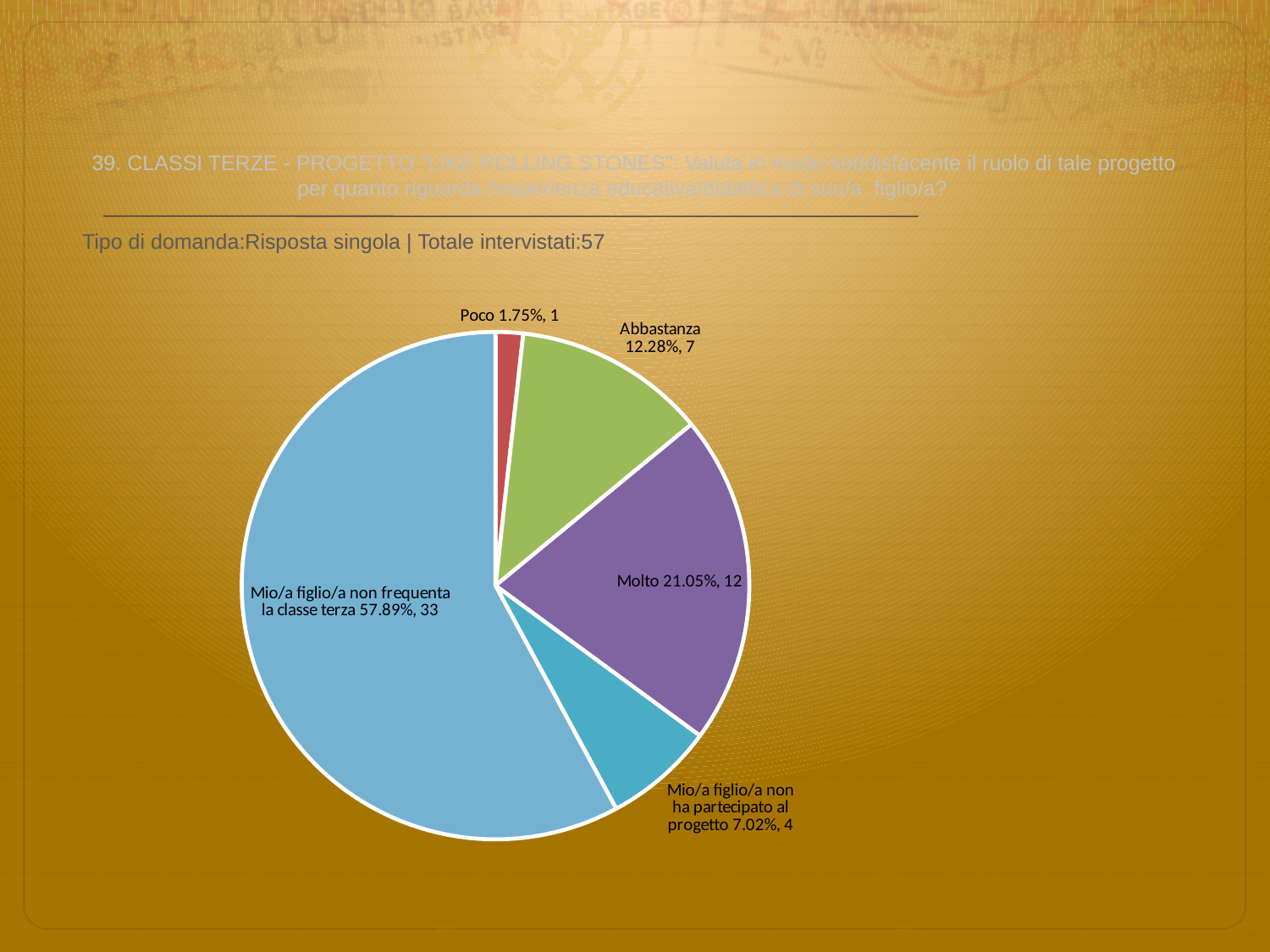
What is the difference in count between 'Molto' and 'Abbastanza'? 5 What kind of chart is shown on the slide? pie chart What percentage share does the 'Molto' slice have? 21.05% How many respondents answered 'Mio/a figlio/a non frequenta la classe terza'? 33 How many respondents answered 'Abbastanza'? 7 What percentage share does the 'Poco' slice have? 1.75% How many slices does the pie chart have? 5 Which is larger, the 'Abbastanza' slice or the 'Mio/a figlio/a non ha partecipato al progetto' slice? Abbastanza What is the total number of respondents stated on the slide? 57 What percentage share does the 'Mio/a figlio/a non ha partecipato al progetto' slice have? 7.02% Which category has the smallest slice of the pie? Poco Which category has the largest slice of the pie? Mio/a figlio/a non frequenta la classe terza